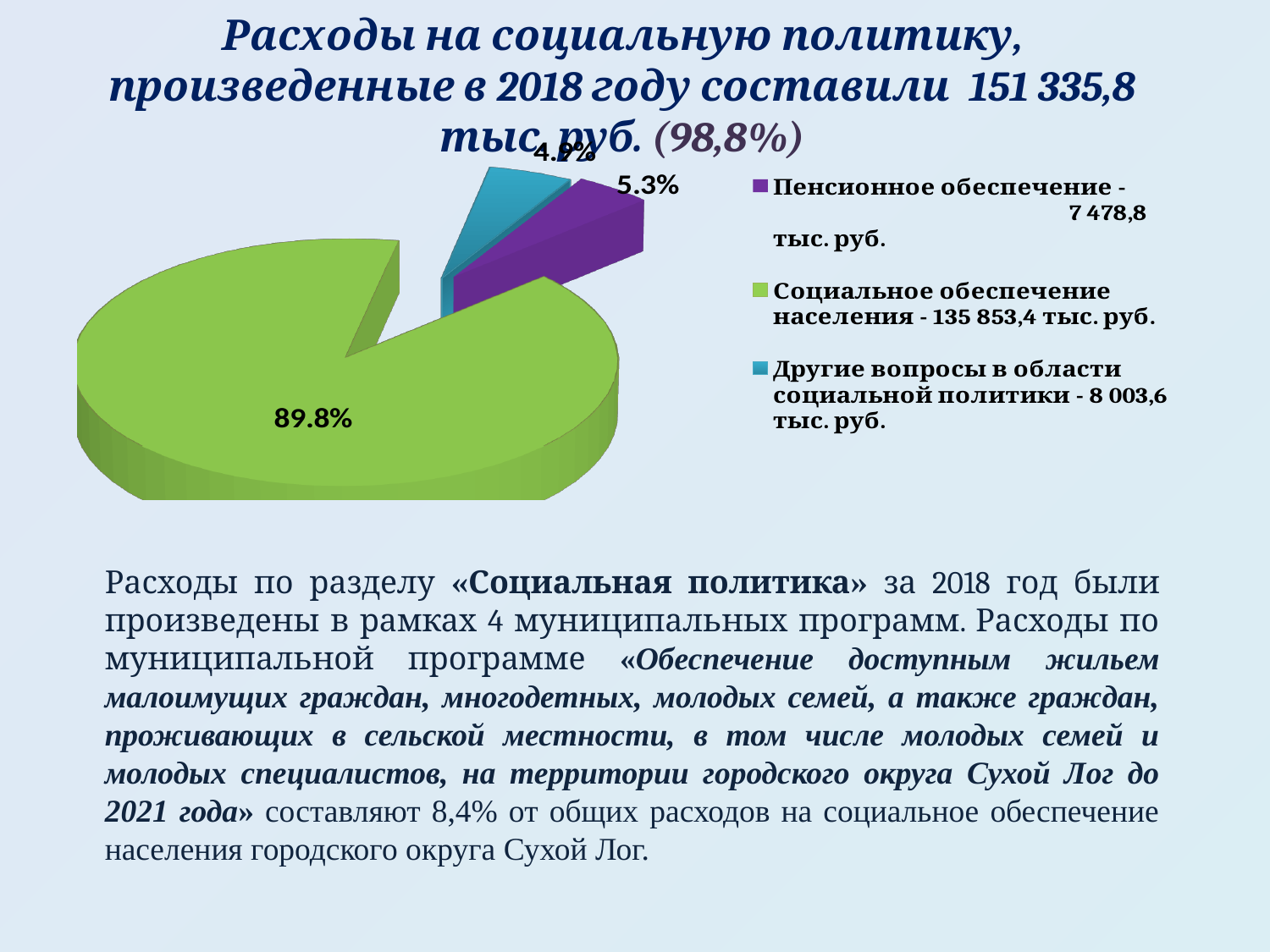
What kind of chart is shown on the slide? pie chart Which category has the largest slice in the pie chart? Социальное обеспечение населения According to the legend amounts, which is larger: Пенсионное обеспечение or Другие вопросы в области социальной политики? Другие вопросы в области социальной политики According to the slide title, what was the total spending on social policy in 2018? 151 335,8 тыс. руб. How many entries does the legend of the pie chart list? 3 How many slices does the pie chart have? 3 What amount does the legend give for Пенсионное обеспечение? 7 478,8 тыс. руб. What is the difference between the legend amounts for Социальное обеспечение населения and Пенсионное обеспечение, in тыс. руб.? 128 374,6 What share of the pie does the largest slice (Социальное обеспечение населения) have? 89.8% What colour is the slice for Социальное обеспечение населения? green What amount does the legend give for Социальное обеспечение населения? 135 853,4 тыс. руб. What amount does the legend give for Другие вопросы в области социальной политики? 8 003,6 тыс. руб.